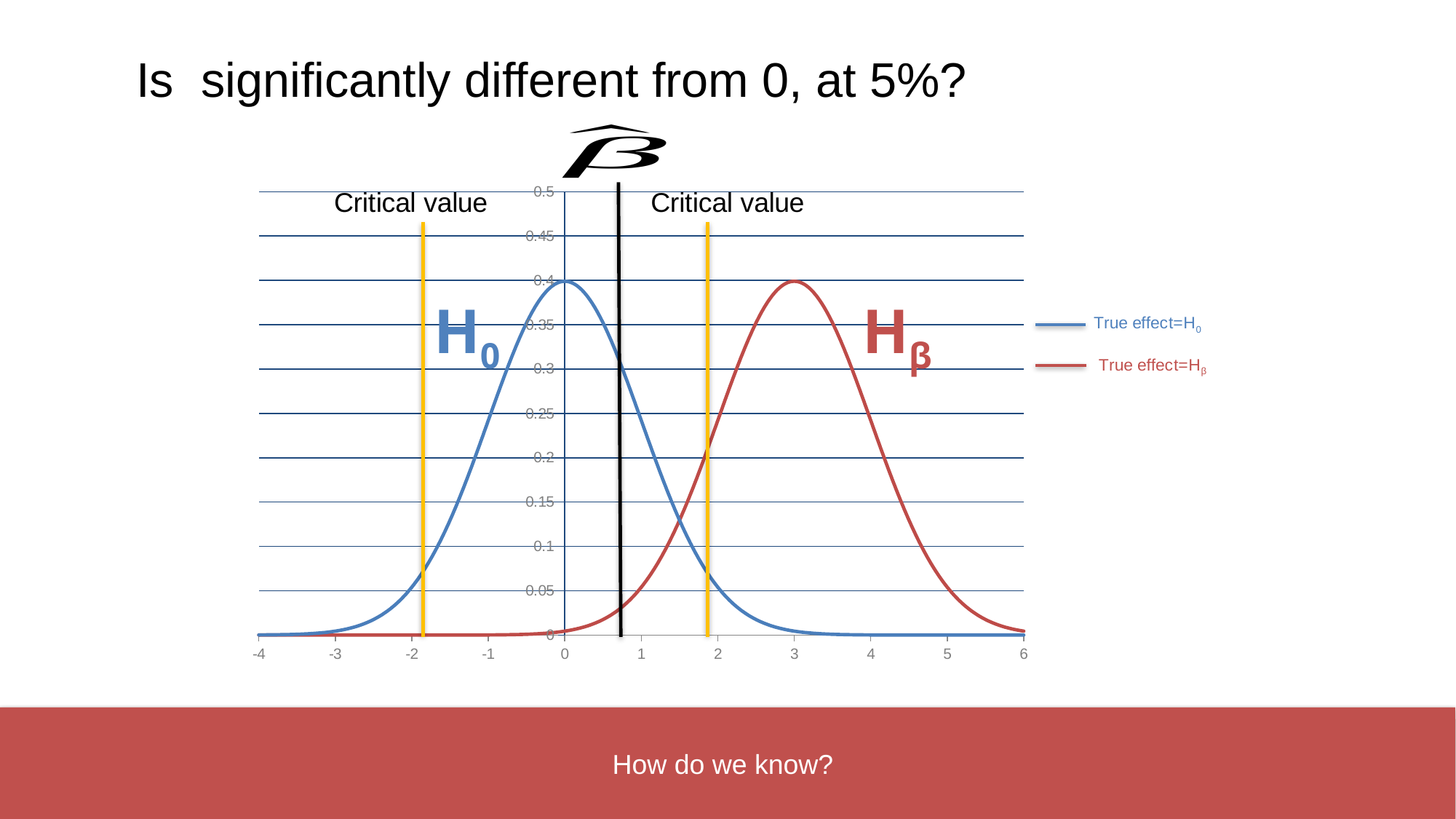
Is the value of the red True effect=Hβ curve at x = 1 greater or less than 0.1? less Is the value of the blue True effect=H0 curve at x = 0 greater or less than 0.35? greater Is the value of the red True effect=Hβ curve at x = 3 greater or less than 0.35? greater What are the two legend entries of the chart? True effect=H0 and True effect=Hβ At which x-axis value does the blue True effect=H0 curve reach its peak? 0 Which series is drawn in red? True effect=Hβ How many series does the legend list? 2 Which series has its peak further to the right along the x axis, True effect=H0 or True effect=Hβ? True effect=Hβ What kind of chart is shown on the slide? line chart At which x-axis value does the red True effect=Hβ curve reach its peak? 3 Does the blue True effect=H0 curve rise or fall as x increases from 0 to 6? fall